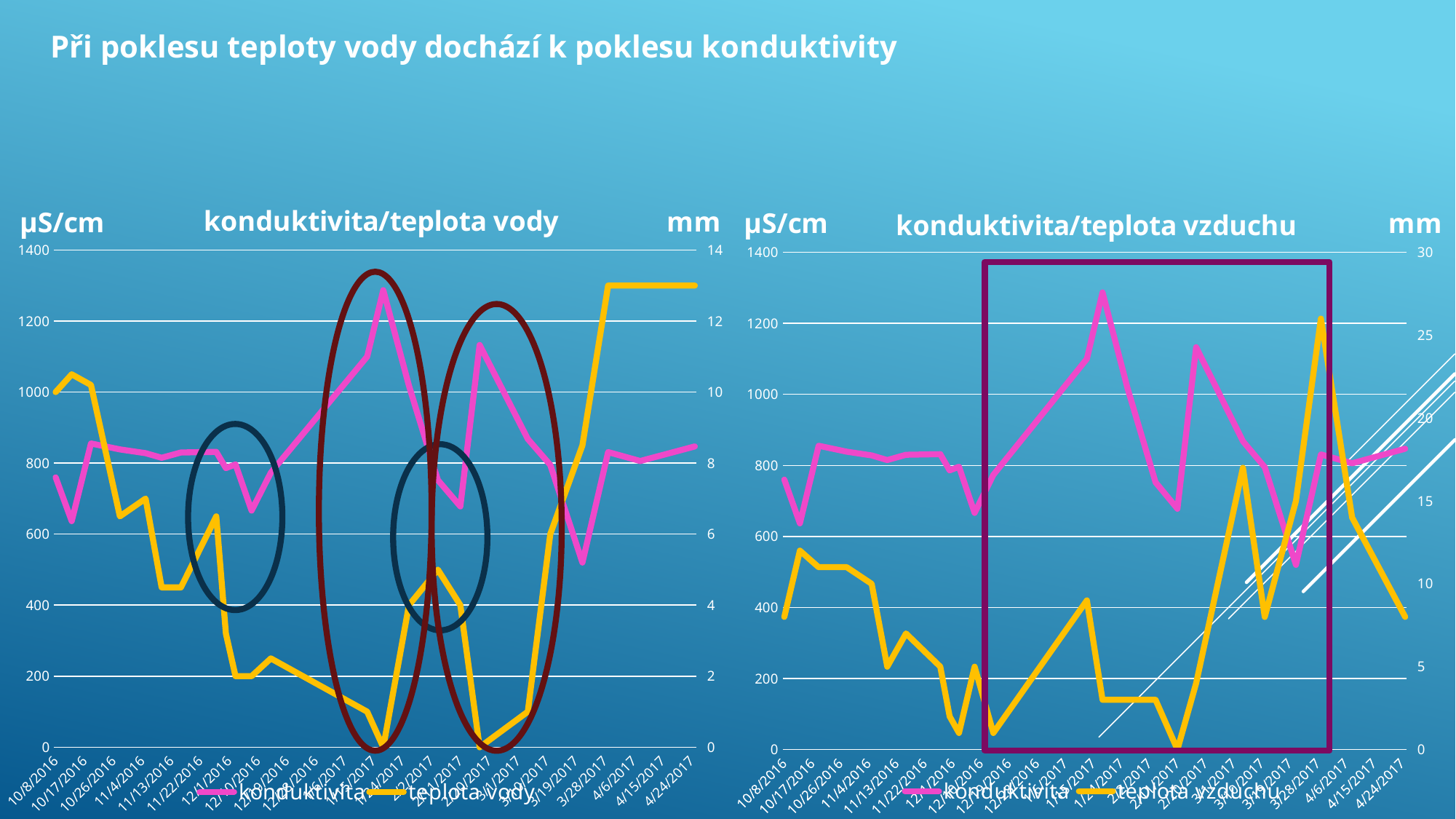
In the 'konduktivita/teplota vody' chart, does the teplota vody line generally rise or fall between 10/8/2016 and 12/28/2016? fall In the 'konduktivita/teplota vzduchu' chart, what is the highest tick shown on the right-hand axis? 30 How many series does the legend of the 'konduktivita/teplota vzduchu' chart list? 2 In the 'konduktivita/teplota vody' chart, what are the two series named in the legend? konduktivita and teplota vody What kind of chart is the 'konduktivita/teplota vody' chart on the left? line chart How many dates are shown on the x axis of the 'konduktivita/teplota vody' chart? 23 In the 'konduktivita/teplota vzduchu' chart, is the highest teplota vzduchu value (right axis) greater or less than 20? greater In the 'konduktivita/teplota vody' chart, is the highest konduktivita value greater or less than 1200? greater In the 'konduktivita/teplota vody' chart, is the konduktivita value at 10/8/2016 greater or less than 600? greater In the 'konduktivita/teplota vzduchu' chart, does the teplota vzduchu line generally rise or fall between 2/11/2017 and 3/28/2017? rise